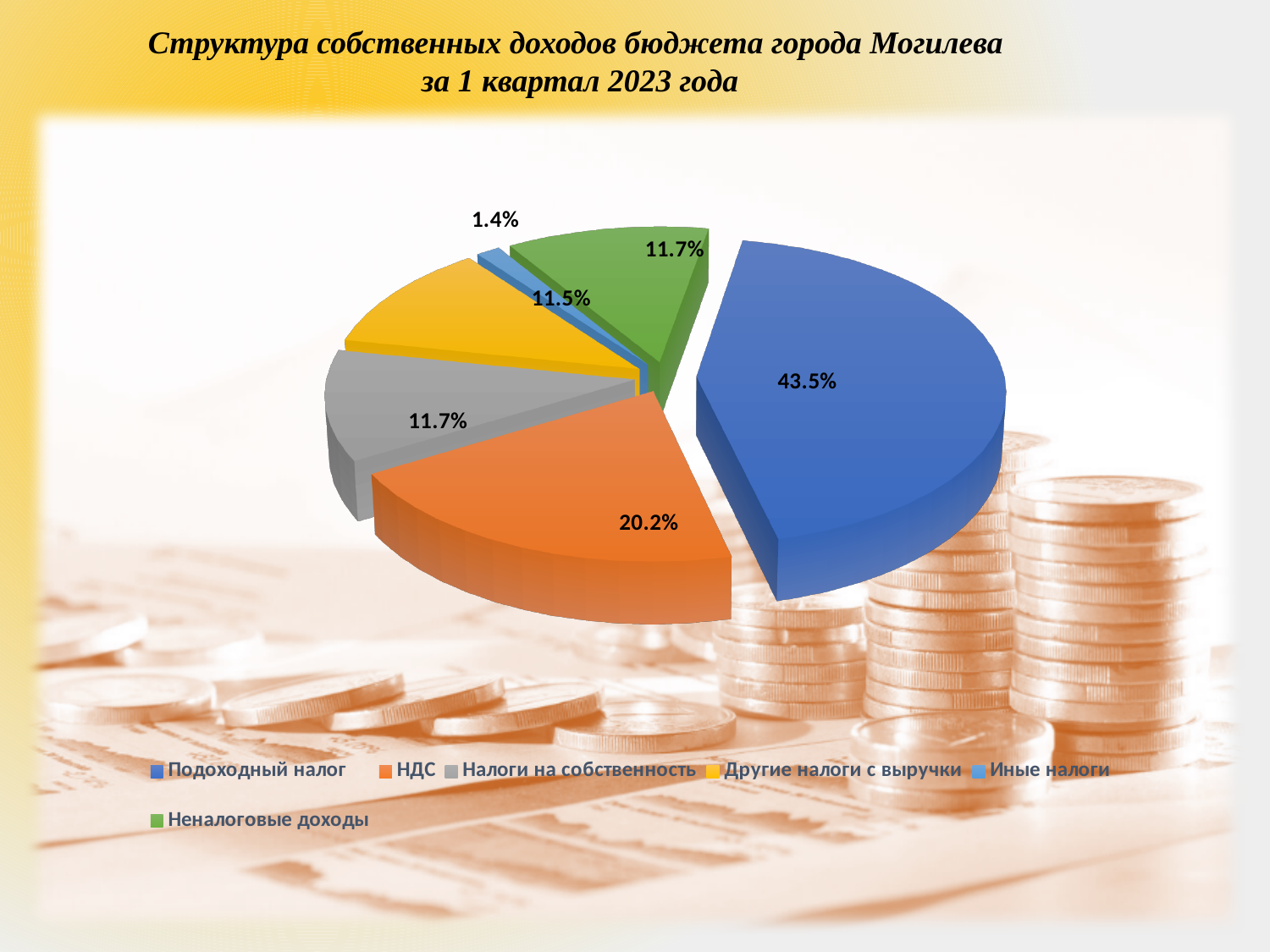
What is the value shown for Неналоговые доходы? 11.7% What share of the pie does Подоходный налог account for? 43.5% Which category has the largest slice of the pie? Подоходный налог Which is larger, the share of НДС or the share of Налоги на собственность? НДС How many categories does the legend list? 6 What colour is the slice for Подоходный налог? Blue What is the combined share of Подоходный налог and НДС? 63.7% What is the difference between the shares of Подоходный налог and НДС? 23.3% What is the value shown for НДС? 20.2% What percentage is shown for Иные налоги? 1.4% Which category has the smallest slice of the pie? Иные налоги What kind of chart is shown on the slide? Pie chart